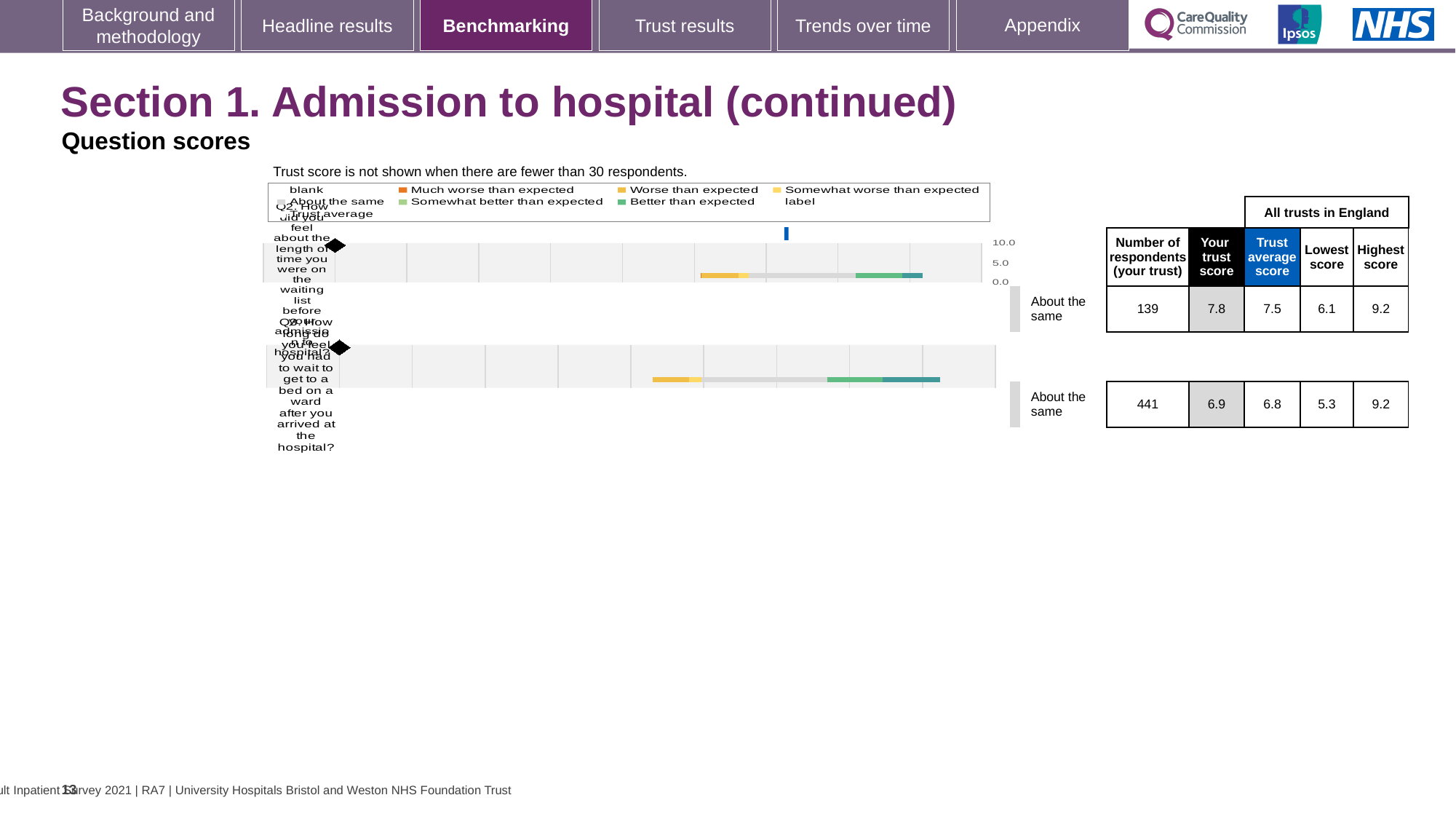
What kind of chart is used to show the question scores on this slide? bar chart Which question has the higher 'Your trust score', Q2 or Q3? Q2 What is the trust average score for Q3 (how long did you feel you had to wait to get to a bed on a ward)? 6.8 What benchmark category is shown for Q2 next to the chart? About the same What is the difference between the highest and lowest scores for Q3? 3.9 What is the 'Your trust score' for Q2 (how did you feel about the length of time on the waiting list)? 7.8 What is the difference between the trust score and the trust average score for Q2? 0.3 Which legend entry is shown in orange in the question scores chart? Much worse than expected Is the trust score for Q3 greater or less than 5.0 on the chart axis? greater How many respondents answered Q3 at this trust? 441 How many questions are plotted in the question scores chart? 2 What is the lowest score across all trusts in England for Q2? 6.1